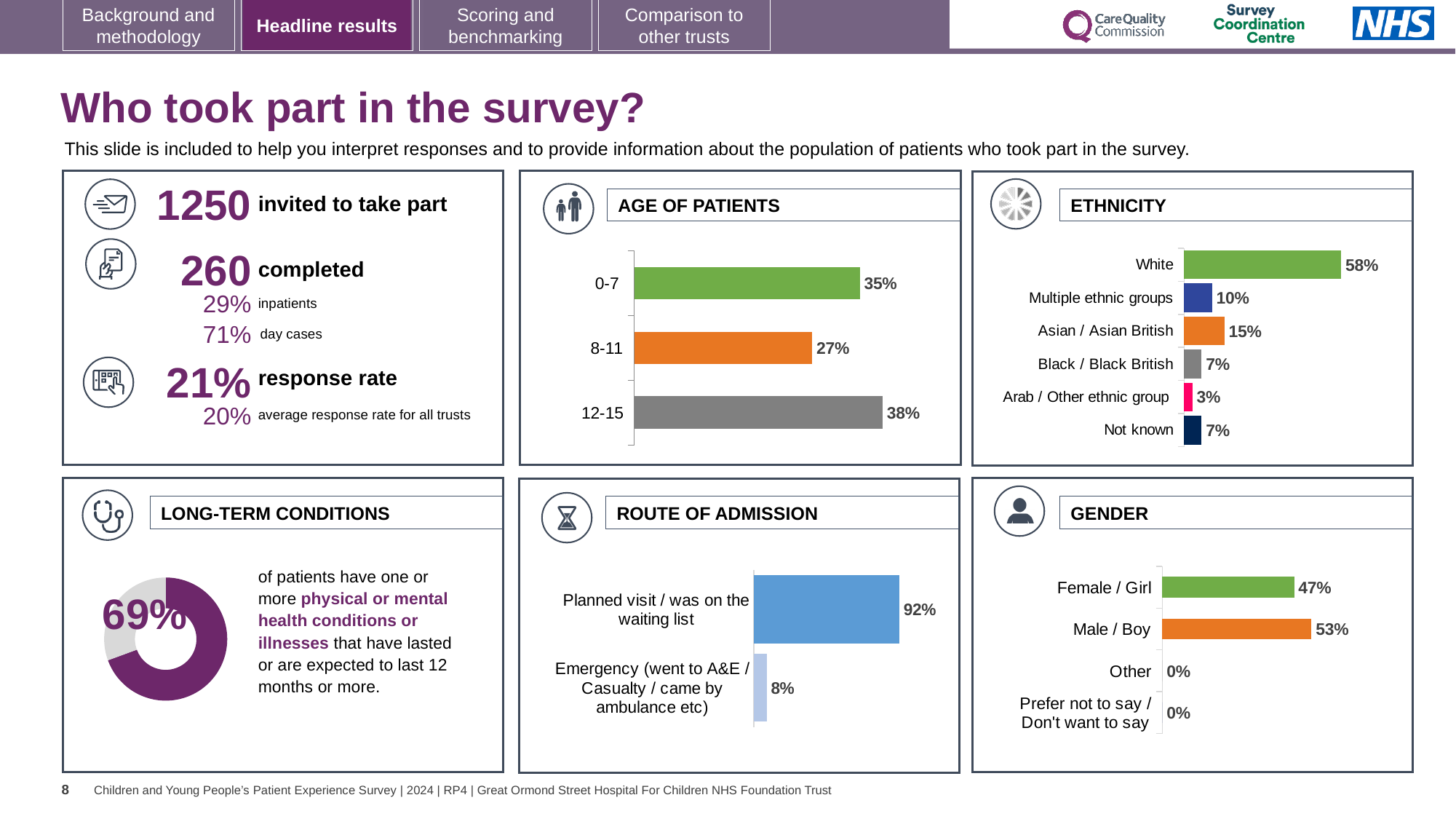
In the AGE OF PATIENTS chart, what is the difference between the 12-15 and 0-7 values? 3% In the AGE OF PATIENTS chart, which age group has the highest value? 12-15 In the GENDER chart, what is the value for Male / Boy? 53% In the ROUTE OF ADMISSION chart, what is the difference between the Planned visit and Emergency values? 84% In the AGE OF PATIENTS chart, what is the value for the 8-11 age group? 27% In the GENDER chart, which is larger: Female / Girl or Male / Boy? Male / Boy In the ROUTE OF ADMISSION chart, what is the value for Emergency (went to A&E / Casualty / came by ambulance etc)? 8% In the ETHNICITY chart, which is larger: Multiple ethnic groups or Black / Black British? Multiple ethnic groups In the ETHNICITY chart, how many categories are shown? 6 In the ETHNICITY chart, which category has the lowest value? Arab / Other ethnic group What kind of chart is used in the LONG-TERM CONDITIONS panel? Doughnut chart In the ETHNICITY chart, what is the value for Asian / Asian British? 15%